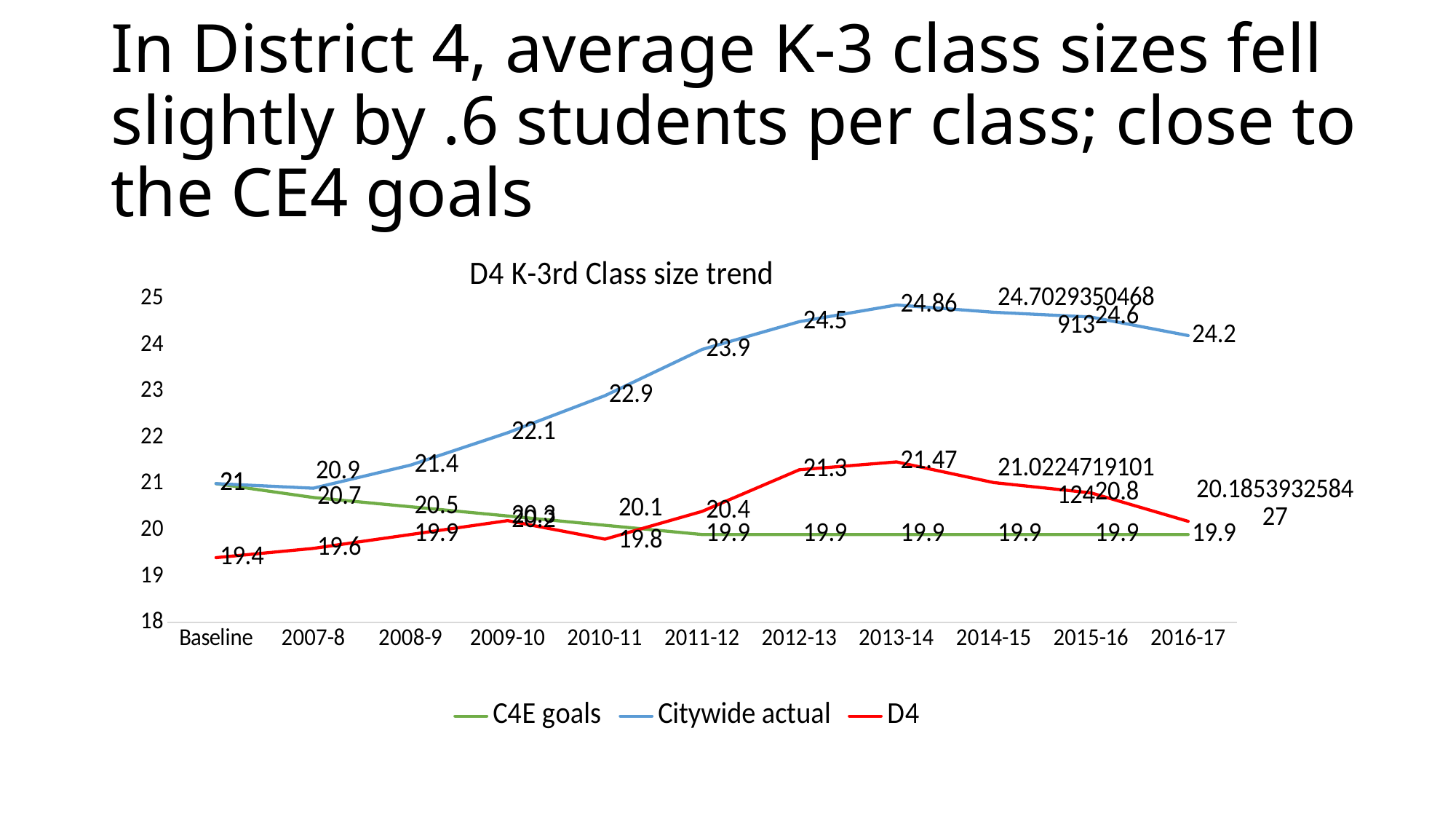
How many categories are shown on the x axis of the chart? 11 What is the D4 value for 2013-14? 21.47 What is the C4E goals value for 2008-9? 20.5 In which year is the Citywide actual value highest? 2013-14 What is the D4 value at Baseline? 19.4 How many series does the legend of the chart list? 3 What kind of chart is shown on the slide? line chart What is the title of the chart? D4 K-3rd Class size trend Is the Citywide actual value for 2016-17 greater or less than 24? greater What is the Citywide actual value for 2013-14? 24.86 What is the difference between the Citywide actual value and the D4 value in 2011-12? 3.5 In which year is the D4 value lowest? Baseline